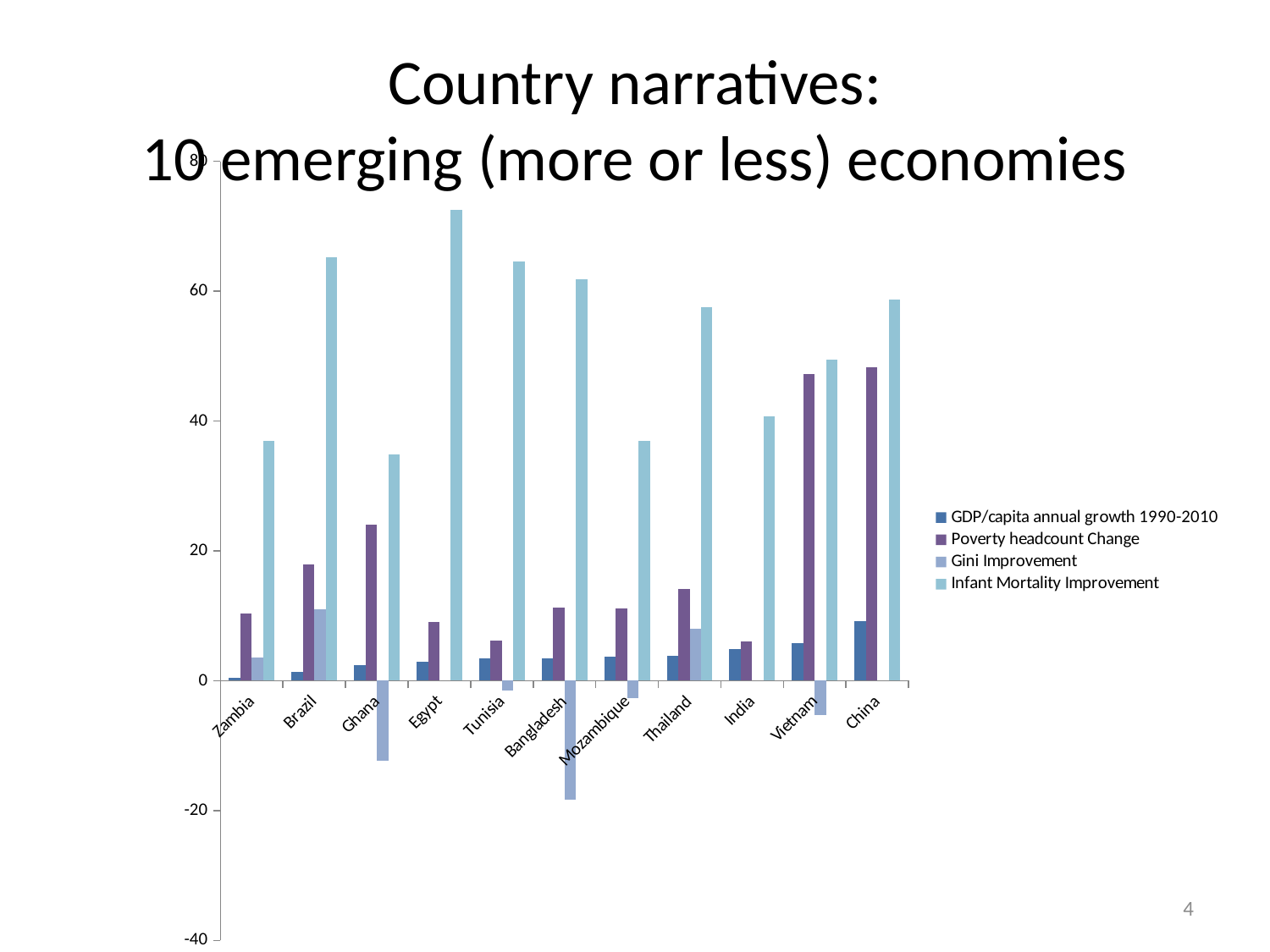
Which country has the highest Infant Mortality Improvement value? Egypt Which is larger, the Poverty headcount Change for Brazil or for Ghana? Ghana Which is larger, the Infant Mortality Improvement for Thailand or for Mozambique? Thailand Do the GDP/capita annual growth 1990-2010 values generally rise or fall from Zambia to China along the x axis? rise Is the Gini Improvement value for Bangladesh greater or less than 0? less Which country has the highest GDP/capita annual growth 1990-2010? China What kind of chart is shown on the slide? bar chart How many countries are shown on the x axis of the chart? 11 Is the Poverty headcount Change value for China greater or less than 40? greater Which country has the lowest Gini Improvement value? Bangladesh How many series does the chart's legend list? 4 Is the Infant Mortality Improvement value for Egypt greater or less than 60? greater